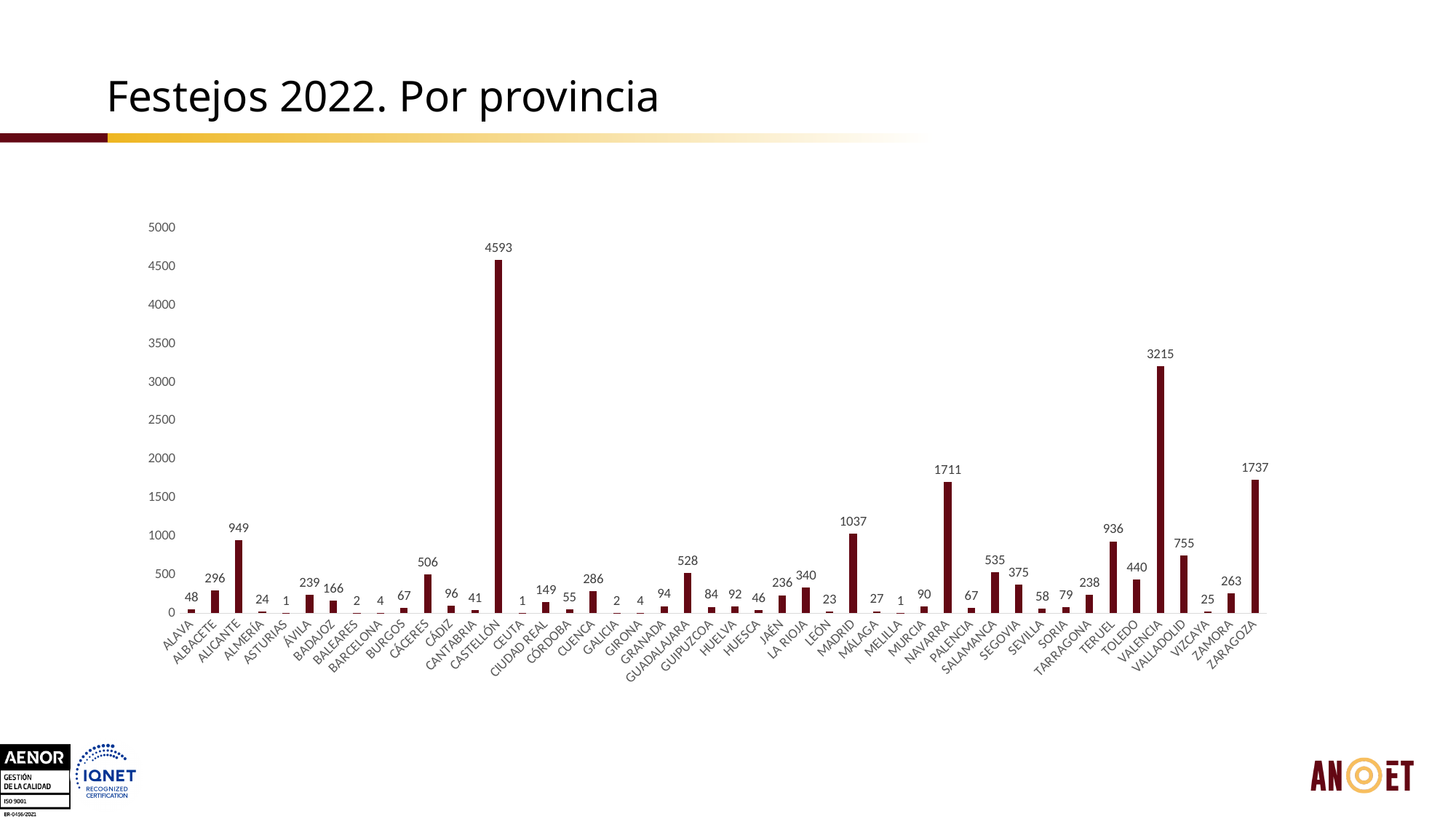
What is the value for NAVARRA? 1711 How many provinces are shown on the x axis of the chart? 46 What is the difference between the values for VALENCIA and ZARAGOZA? 1478 What is the value for TERUEL? 936 What is the value for VALENCIA? 3215 What is the title of the chart on the slide? Festejos 2022. Por provincia What is the value for MADRID? 1037 Which has a larger value, ZARAGOZA or NAVARRA? ZARAGOZA What type of chart is shown on the slide? bar chart What is the value for CASTELLÓN? 4593 Which province has the highest value in the chart? CASTELLÓN Is the value for VALLADOLID greater or less than 500? greater